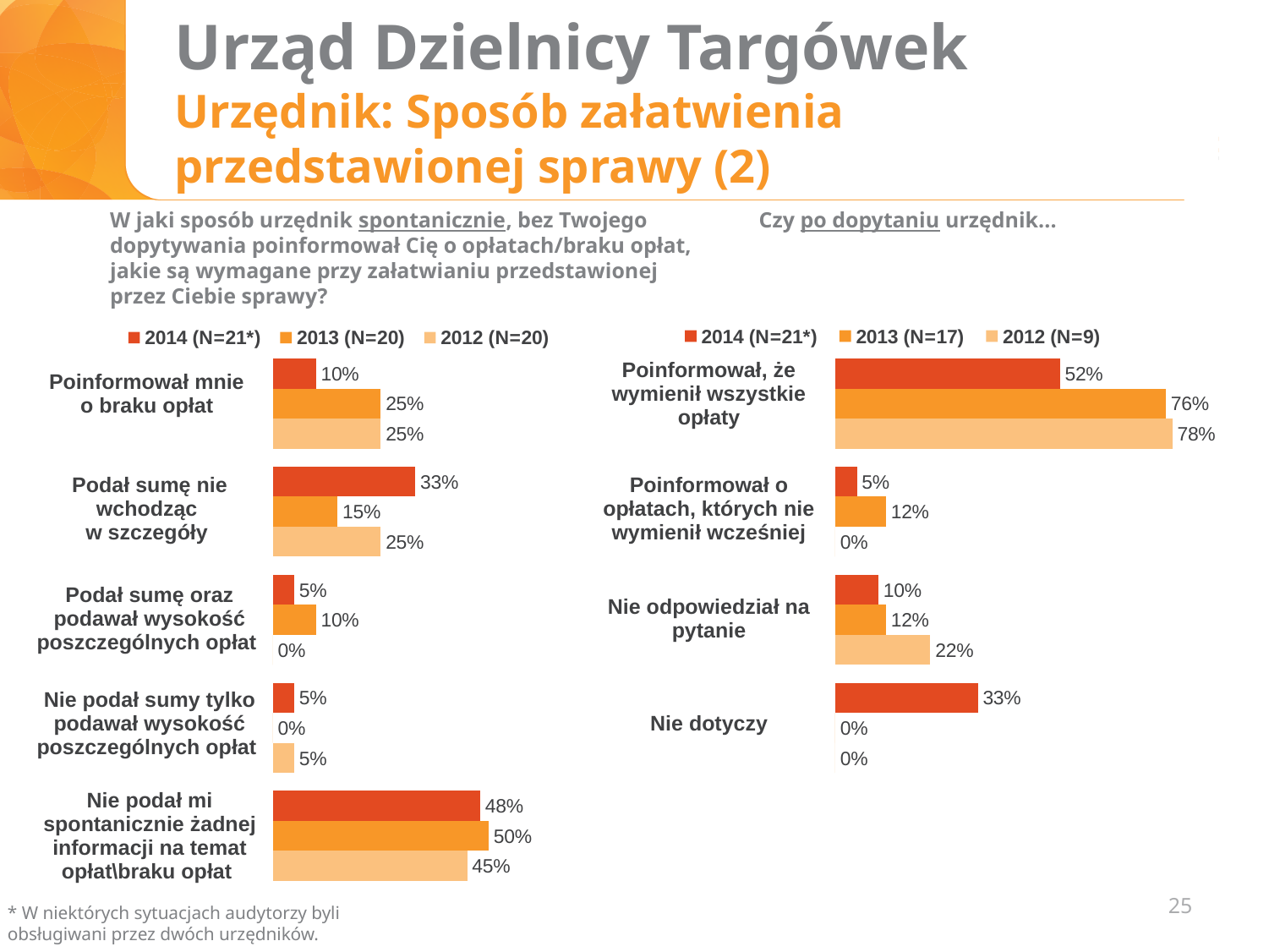
In the left chart (spontaneous information about fees), what is the 2014 value for "Nie podał mi spontanicznie żadnej informacji na temat opłat\braku opłat"? 48% In the left chart, which is larger for "Poinformował mnie o braku opłat": the 2014 value or the 2013 value? 2013 How many categories does the left chart show? 5 What type of chart is the left chart? Bar chart In the right chart, what sample size (N) is given in the legend for 2012? N=9 How many categories does the right chart show? 4 How many series does the legend of the right chart list? 3 In the right chart, what is the difference between the 2013 and 2014 values for "Poinformował, że wymienił wszystkie opłaty"? 24 percentage points In the right chart, which category has the highest 2014 value? Poinformował, że wymienił wszystkie opłaty In the left chart, what is the 2013 value for "Podał sumę nie wchodząc w szczegóły"? 15% In the right chart ("Czy po dopytaniu urzędnik..."), what is the 2012 value for "Poinformował, że wymienił wszystkie opłaty"? 78% In the left chart, which category has the lowest 2013 value? Nie podał sumy tylko podawał wysokość poszczególnych opłat